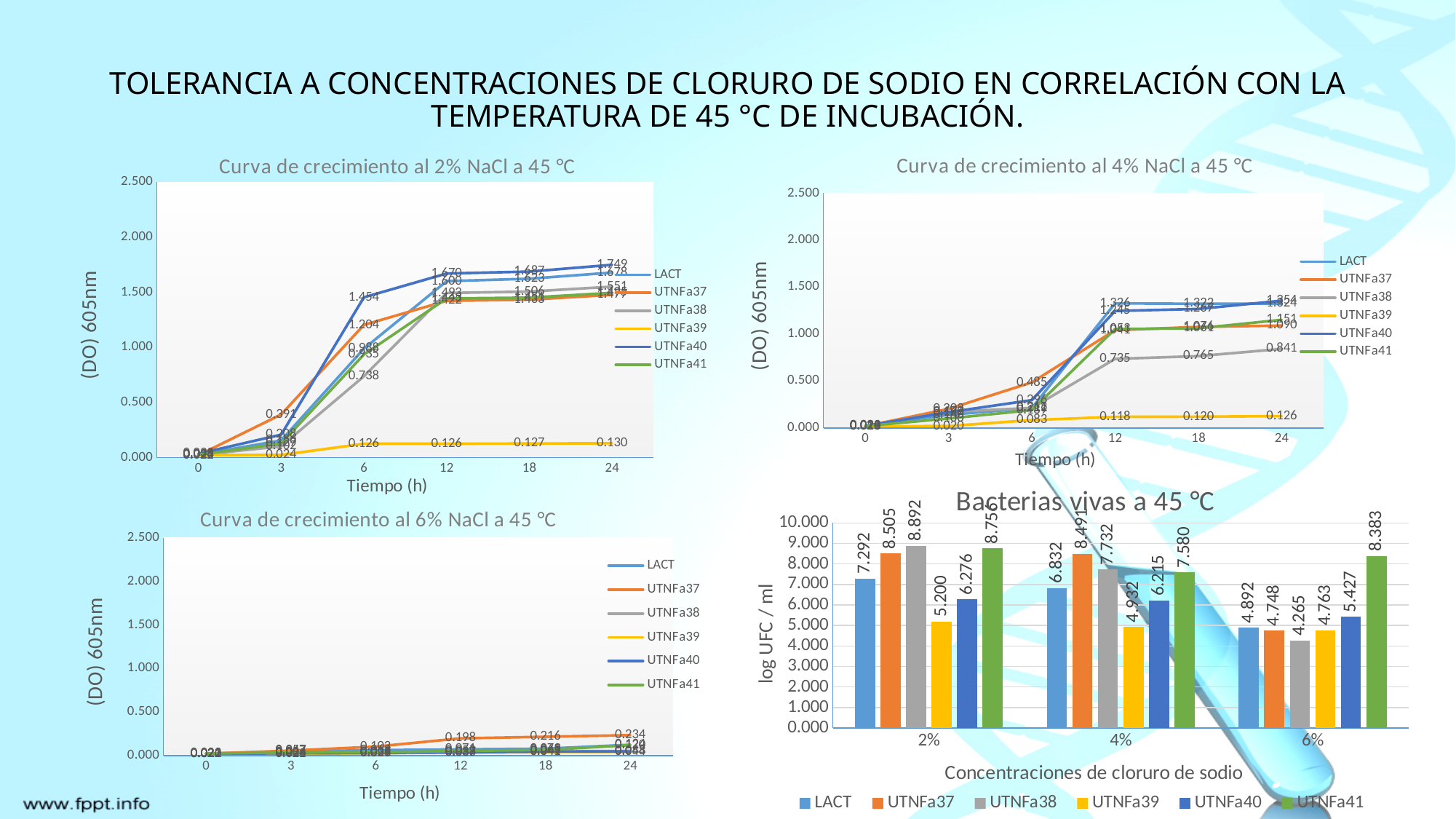
What kind of chart is "Bacterias vivas a 45 °C"? Bar chart In the chart titled "Curva de crecimiento al 6% NaCl a 45 °C", what is the value for UTNFa37 at 18 h? 0.216 In the chart titled "Bacterias vivas a 45 °C", which series has the highest value at 4%? UTNFa37 In the chart titled "Bacterias vivas a 45 °C", what is the value for UTNFa38 at 2%? 8.892 In the chart titled "Bacterias vivas a 45 °C", how many series does the legend list? 6 In the chart titled "Bacterias vivas a 45 °C", which is larger: UTNFa39 at 2% or UTNFa39 at 4%? UTNFa39 at 2% In the chart titled "Curva de crecimiento al 4% NaCl a 45 °C", what is the value for UTNFa38 at 24 h? 0.841 In the chart titled "Bacterias vivas a 45 °C", what is the value for UTNFa41 at 6%? 8.383 In the chart titled "Bacterias vivas a 45 °C", which series has the lowest value at 6%? UTNFa38 In the chart titled "Curva de crecimiento al 2% NaCl a 45 °C", how many time points are shown on the x axis? 6 In the chart titled "Curva de crecimiento al 2% NaCl a 45 °C", what is the value for UTNFa39 at 24 h? 0.130 In the chart titled "Bacterias vivas a 45 °C", what is the difference between the LACT values at 2% and 6%? 2.400